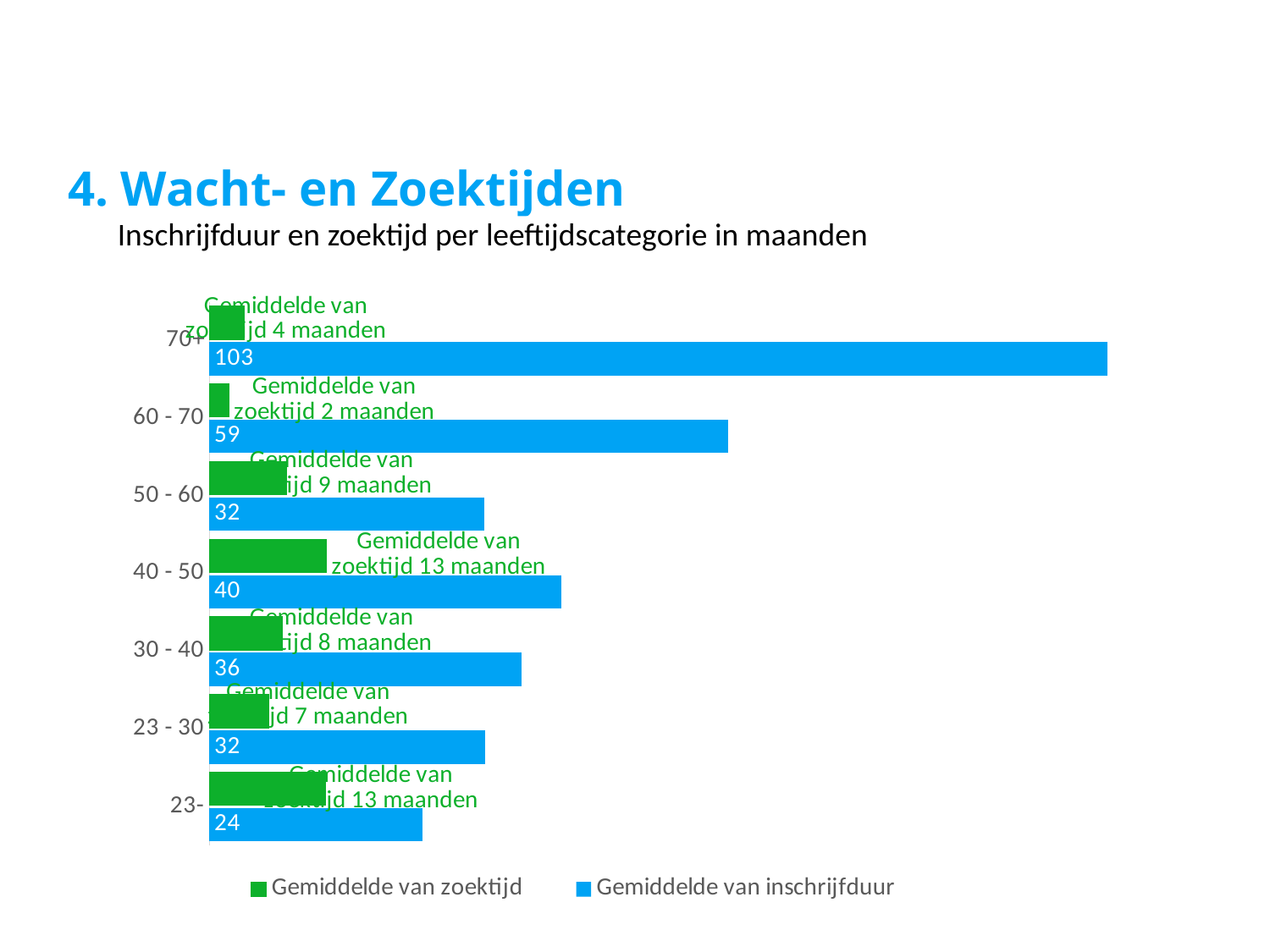
Which age category has the highest Gemiddelde van inschrijfduur? 70+ What type of chart is shown on the slide? bar chart How many age categories are shown on the chart? 7 What is the Gemiddelde van inschrijfduur for the 70+ category? 103 What is the Gemiddelde van inschrijfduur for the 60 - 70 category? 59 What is the Gemiddelde van inschrijfduur for the 23- category? 24 What is the Gemiddelde van zoektijd for the 40 - 50 category, in months? 13 maanden Which age category has the lowest Gemiddelde van zoektijd? 60 - 70 Which is larger, the Gemiddelde van inschrijfduur for 40 - 50 or for 30 - 40? 40 - 50 What is the difference in Gemiddelde van inschrijfduur between the 70+ and 60 - 70 categories? 44 How many series does the legend list? 2 Which colour represents Gemiddelde van inschrijfduur in the chart? blue